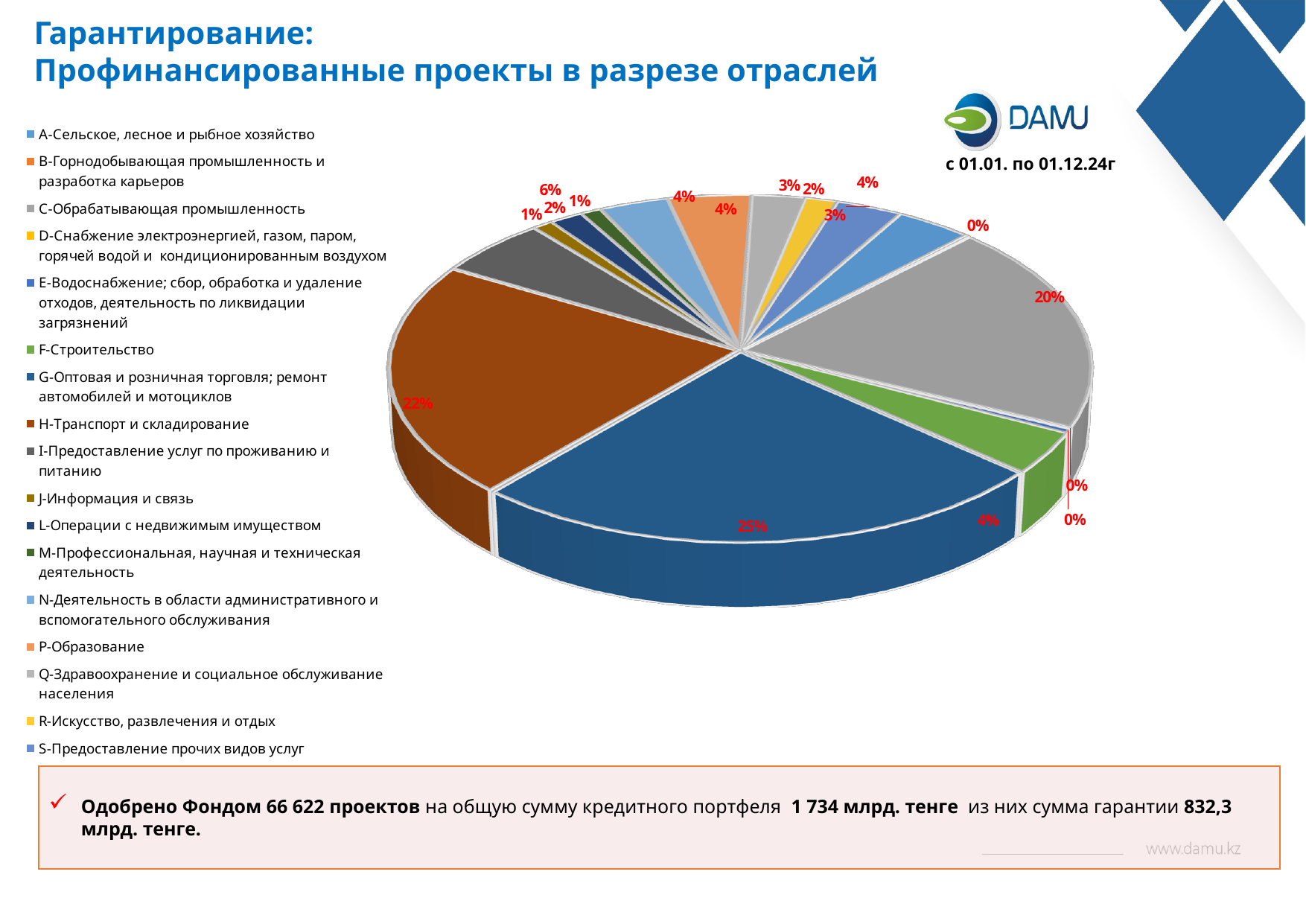
What kind of chart is shown on the slide? Pie chart What share of the pie chart does G-Оптовая и розничная торговля; ремонт автомобилей и мотоциклов have? 25% What period does the chart cover, according to the label next to the logo? с 01.01. по 01.12.24г What is the share for H-Транспорт и складирование in the pie chart? 22% What is the difference in percentage points between the shares of G-Оптовая и розничная торговля and H-Транспорт и складирование? 3% What is the share for F-Строительство in the pie chart? 4% Which industry has the largest share of financed projects in the pie chart? G-Оптовая и розничная торговля; ремонт автомобилей и мотоциклов What is the title of the slide containing the pie chart? Гарантирование: Профинансированные проекты в разрезе отраслей How many industry categories are listed in the chart legend? 17 Which has a larger share: H-Транспорт и складирование or C-Обрабатывающая промышленность? H-Транспорт и складирование What is the share for I-Предоставление услуг по проживанию и питанию in the pie chart? 6% What is the share for C-Обрабатывающая промышленность in the pie chart? 20%